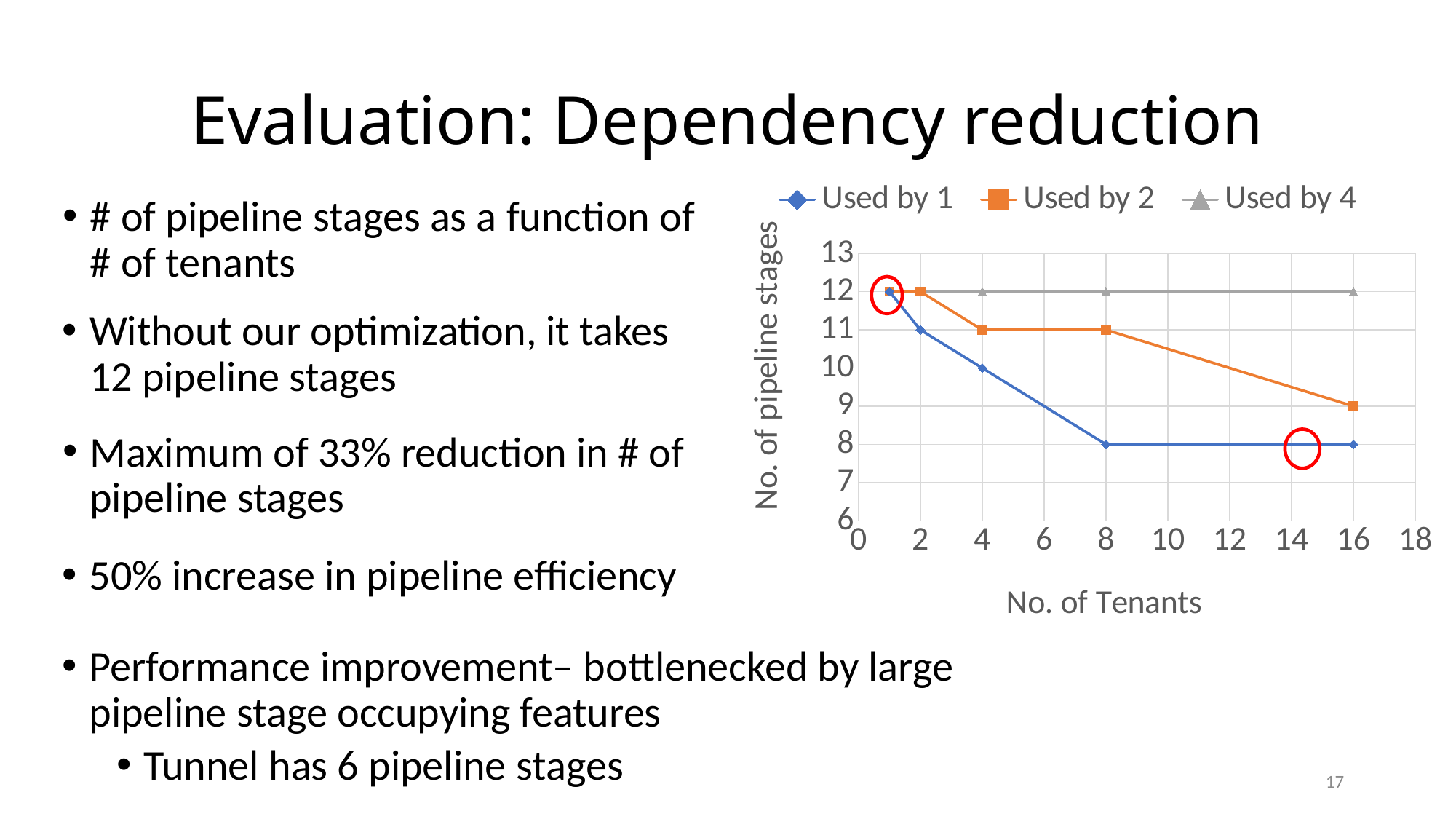
How many series does the chart legend list? 3 What is the label of the y axis of the chart? No. of pipeline stages What is the label of the x axis of the chart? No. of Tenants What is the difference in pipeline stages between the 'Used by 4' and 'Used by 1' series at 16 tenants? 4 What is the number of pipeline stages for the 'Used by 1' series at 16 tenants? 8 What is the number of pipeline stages for the 'Used by 4' series at 16 tenants? 12 Which series has the lowest number of pipeline stages at 8 tenants? Used by 1 Does the 'Used by 1' series rise or fall as the number of tenants increases from 1 to 8? Fall Which series has the highest number of pipeline stages at 16 tenants? Used by 4 What is the number of pipeline stages for the 'Used by 2' series at 16 tenants? 9 What is the number of pipeline stages for the 'Used by 1' series at 4 tenants? 10 What kind of chart is shown on the slide? Line chart